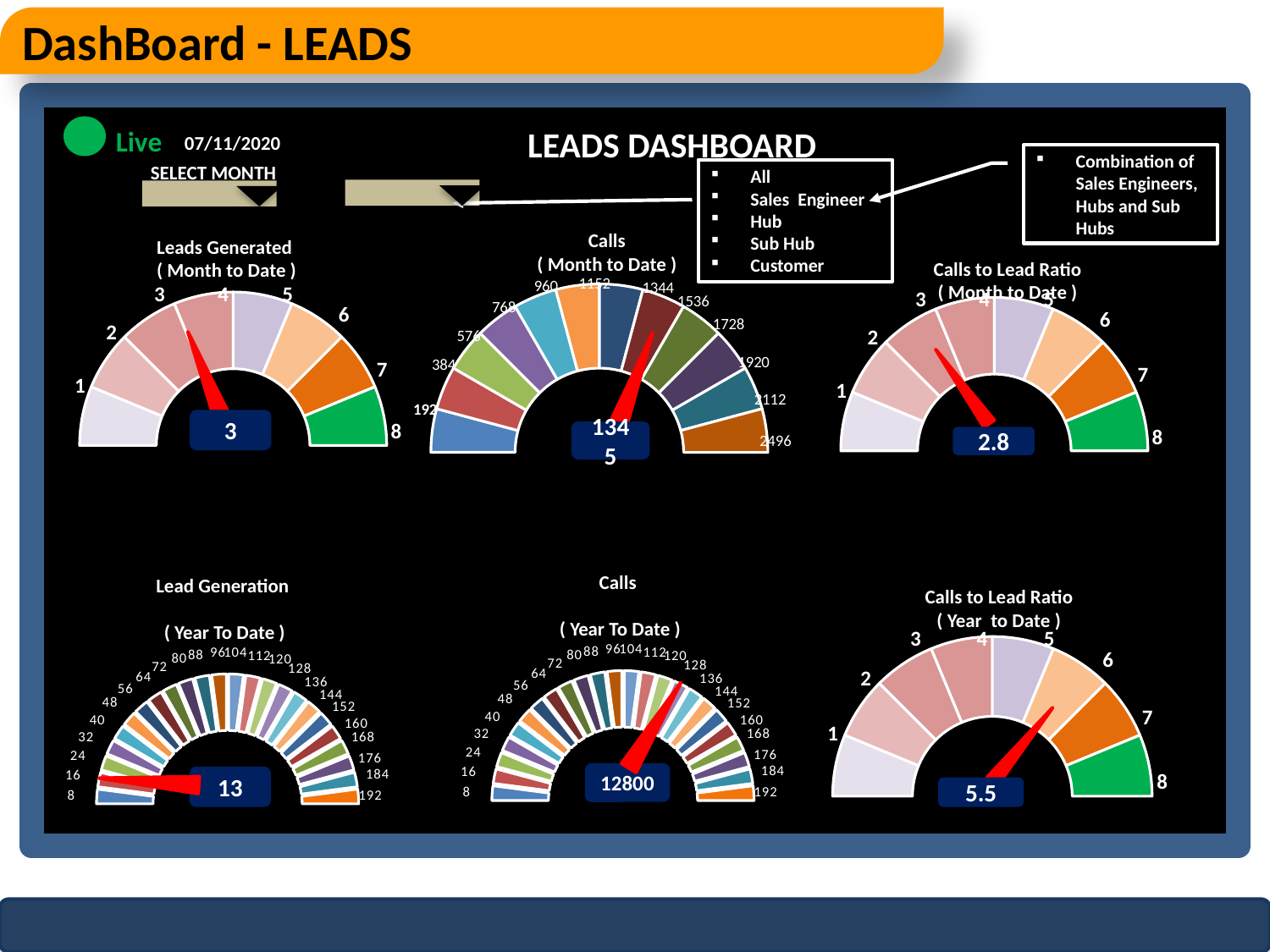
How many gauge charts are shown on the dashboard? 6 What value is displayed on the Lead Generation (Year To Date) gauge? 13 What date is shown next to the 'Live' indicator on the dashboard? 07/11/2020 What is the difference between the Calls to Lead Ratio (Year to Date) value and the Calls to Lead Ratio (Month to Date) value? 2.7 What value is displayed on the Calls to Lead Ratio (Year to Date) gauge? 5.5 What value is displayed on the Calls (Year To Date) gauge? 12800 What kind of chart is used for each of the six metrics on the dashboard? Gauge chart What is the highest tick label on the Calls (Month to Date) gauge scale? 2496 What value is displayed on the Leads Generated (Month to Date) gauge? 3 What is the difference between the Lead Generation (Year To Date) value and the Leads Generated (Month to Date) value? 10 What value is displayed on the Calls to Lead Ratio (Month to Date) gauge? 2.8 Which is larger, the Calls to Lead Ratio (Month to Date) value or the Calls to Lead Ratio (Year to Date) value? Calls to Lead Ratio (Year to Date)